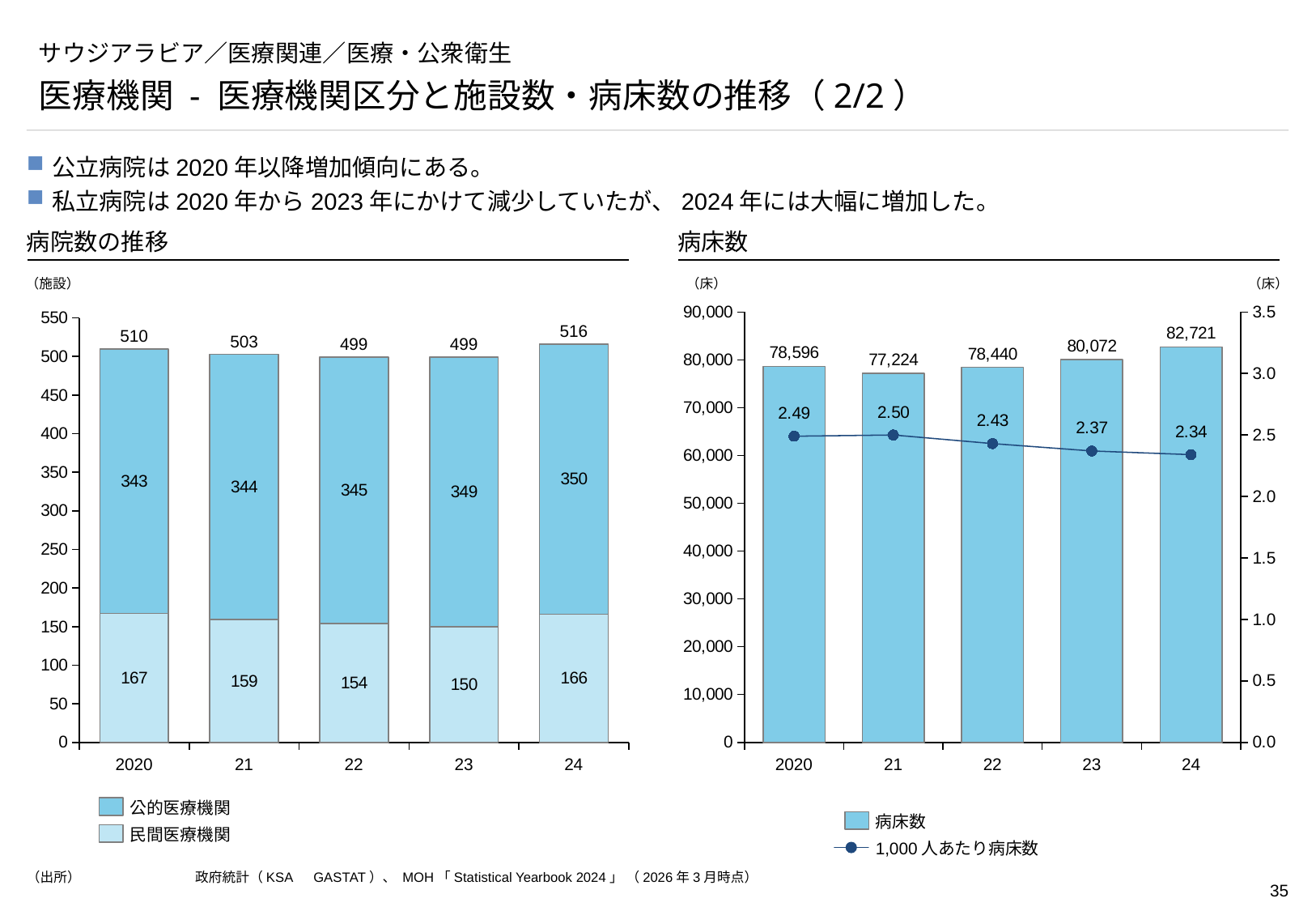
「病床数」のグラフで、2021年の1,000人あたり病床数はいくつですか？ 2.50 「病院数の推移」のグラフの凡例には何系列ありますか？ 2 「病床数」のグラフで、病床数が最も多い年はどれですか？ 24 「病院数の推移」のグラフで、2024年の公的医療機関の値はいくつですか？ 350 「病床数」のグラフで、2021年から2024年にかけて1,000人あたり病床数は増加していますか、減少していますか？ 減少 「病院数の推移」のグラフで、民間医療機関の値が最も低い年はどれですか？ 23 「病院数の推移」のグラフで、2021年の積み上げ棒の合計はいくつですか？ 503 「病床数」のグラフで、2020年と2021年の病床数の差はいくつですか？ 1,372 「病院数の推移」のグラフはどの種類のグラフですか？ 積み上げ棒グラフ 「病院数の推移」のグラフで、2020年と2024年の民間医療機関の値の差はいくつですか？ 1 「病床数」のグラフで、2023年の病床数はいくつですか？ 80,072 「病院数の推移」のグラフで、2022年の民間医療機関の値はいくつですか？ 154